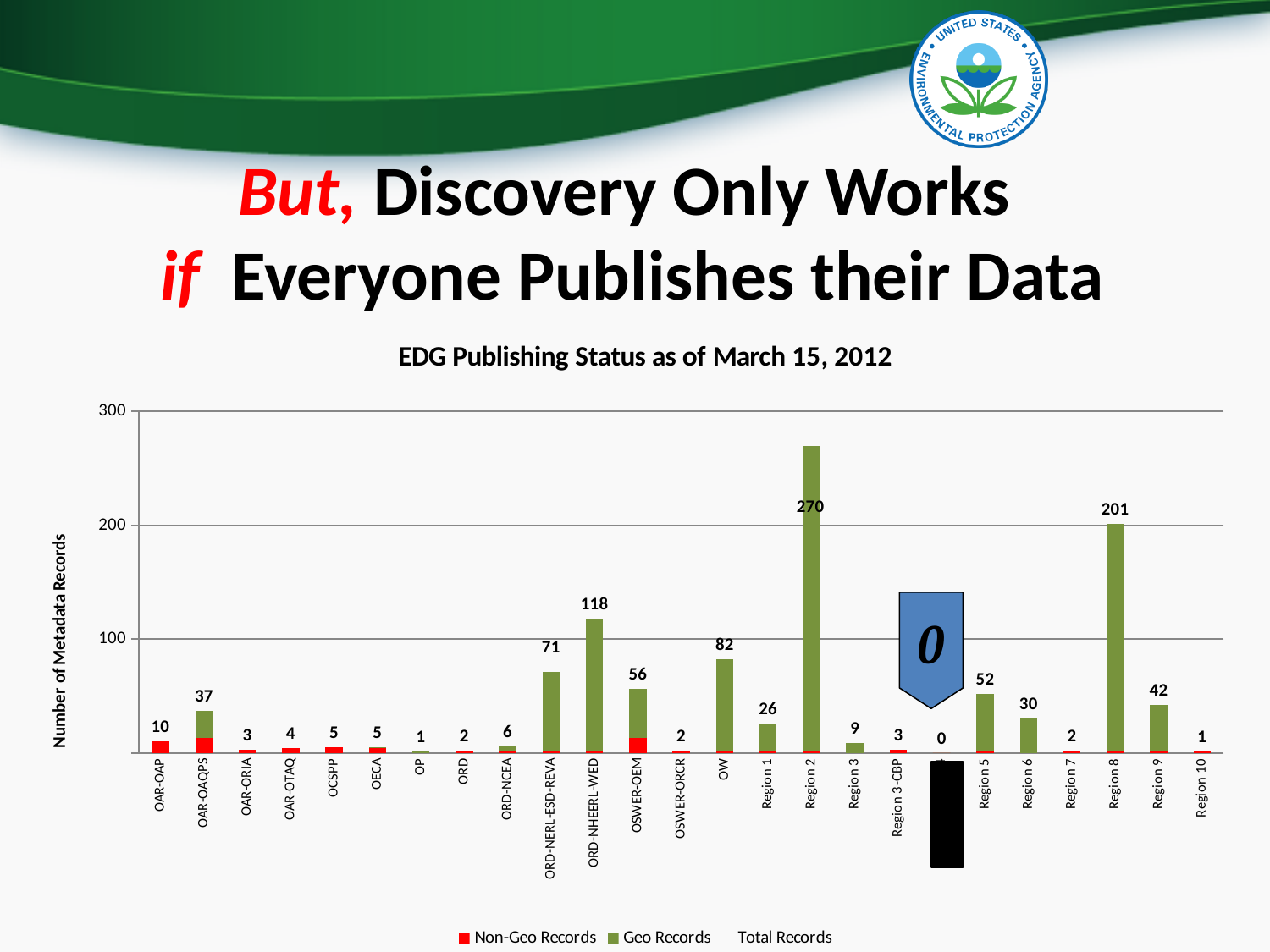
What is the total number of metadata records for Region 8? 201 What kind of chart is shown on the slide? Bar chart How many series does the legend list? 3 What is the total number of metadata records for Region 2? 270 What is the total number of metadata records for OW? 82 Which has more total records, OW or ORD-NERL-ESD-REVA? OW Is the total for Region 2 greater or less than 200? greater Which category has the highest total number of metadata records? Region 2 What is the title of the chart? EDG Publishing Status as of March 15, 2012 What is the difference in total records between Region 2 and Region 8? 69 What is the total number of metadata records for ORD-NHEERL-WED? 118 What is the total number of metadata records for OAR-OAQPS? 37